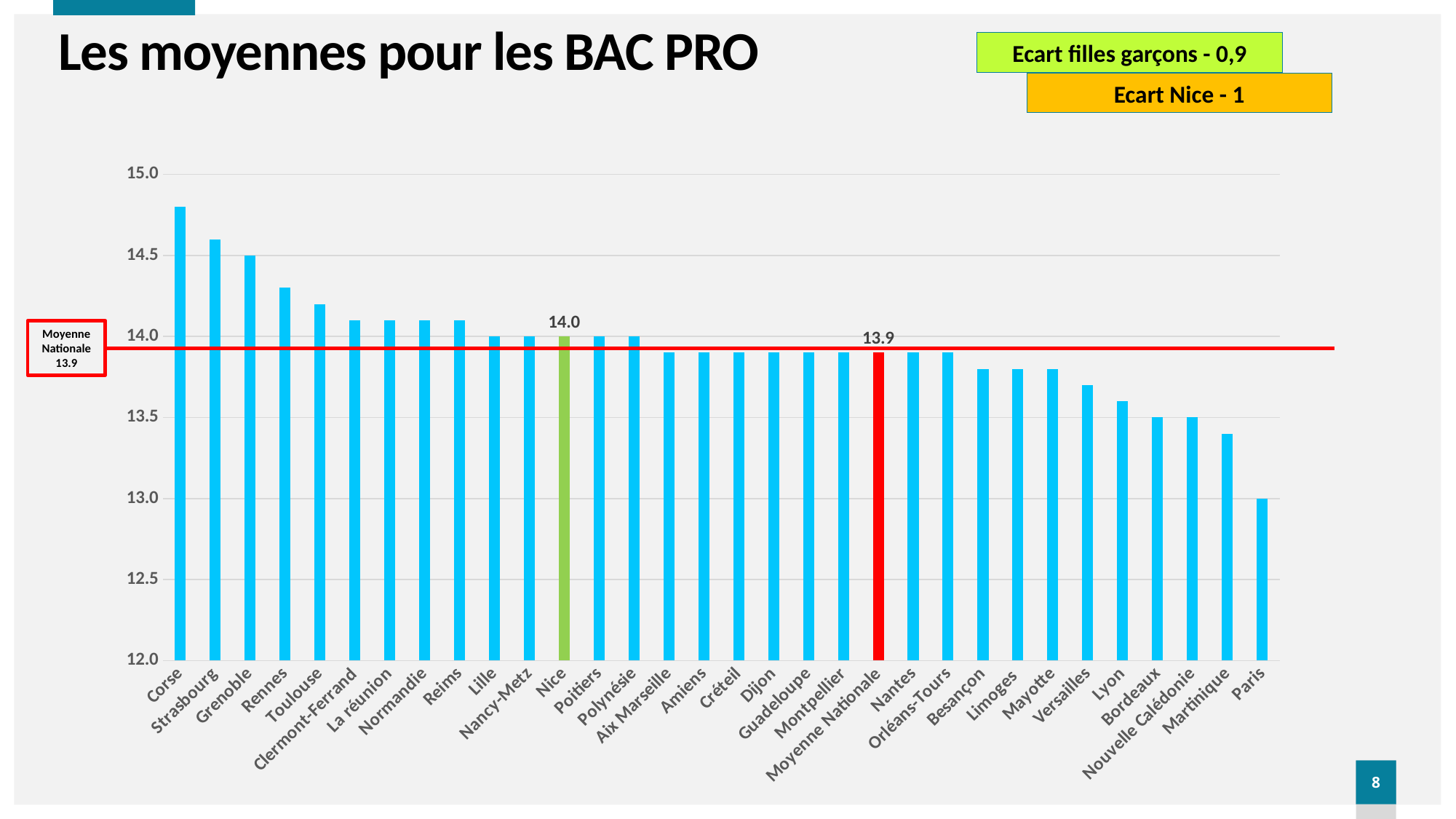
What is the value shown for Nice? 14.0 Which is larger, the value for Corse or the value for Strasbourg? Corse What is the value shown for Moyenne Nationale? 13.9 Which category has the lowest bar? Paris What is the difference between the value for Nice and the value for Moyenne Nationale? 0.1 What is the value for Grenoble? 14.5 How many categories are shown on the x axis? 32 Which category has the highest bar? Corse Is the value for Rennes greater or less than 14.0? greater Is the value for Martinique greater or less than 13.5? less Do the values rise or fall from left to right along the x axis? fall What is the value for Paris? 13.0